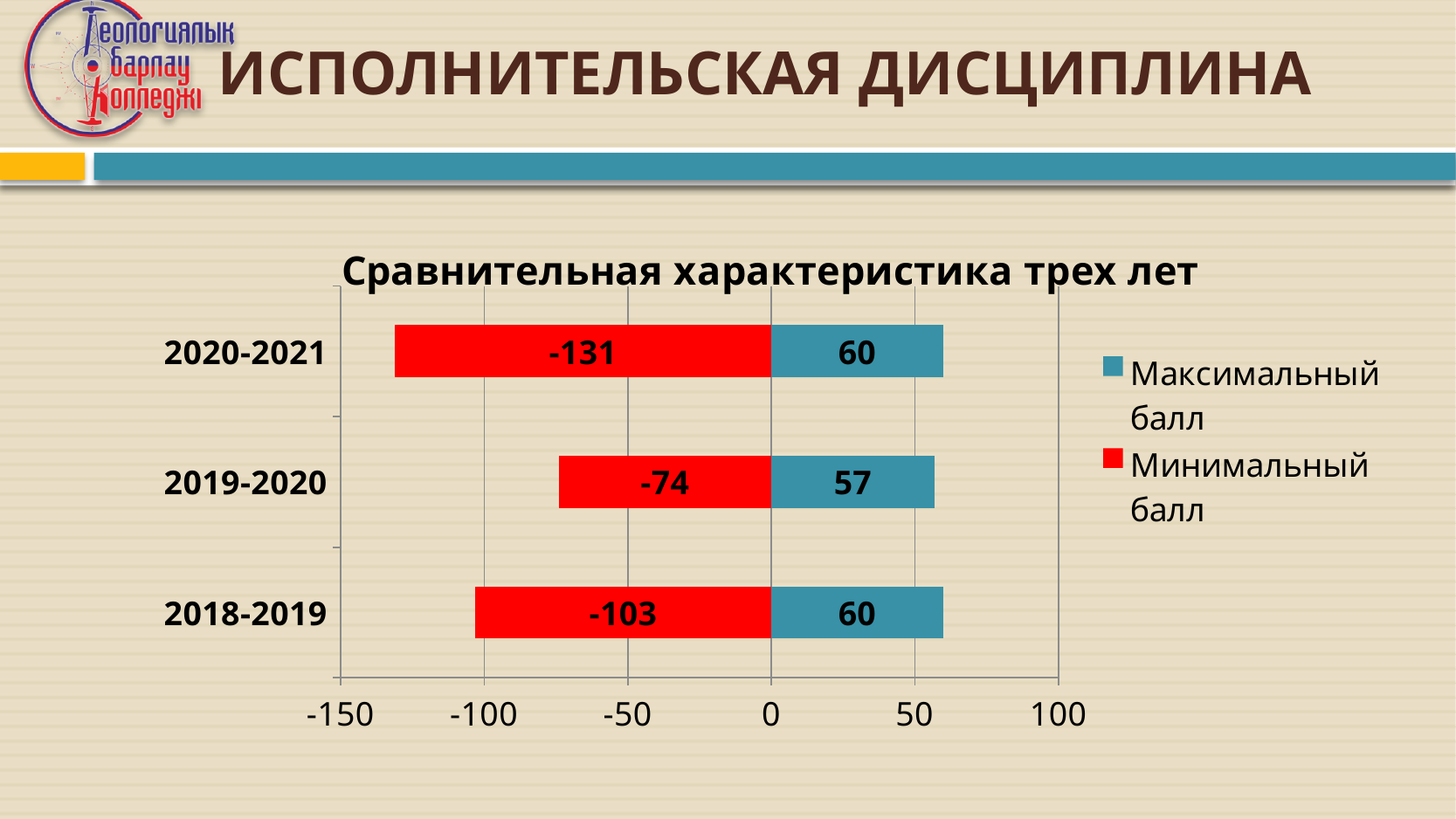
What is the value of Максимальный балл for 2018-2019? 60 Which year has the highest Минимальный балл value? 2019-2020 What is the value of Минимальный балл for 2018-2019? -103 What type of chart is shown on the slide? Bar chart Which is larger, the Максимальный балл for 2020-2021 or for 2019-2020? 2020-2021 Which year has the lowest Минимальный балл value? 2020-2021 How many series does the legend list? 2 What is the difference between the Минимальный балл values for 2020-2021 and 2019-2020? 57 What is the value of Минимальный балл for 2020-2021? -131 How many years (categories) are shown in the chart? 3 What is the value of Максимальный балл for 2019-2020? 57 Which year has the lowest Максимальный балл value? 2019-2020